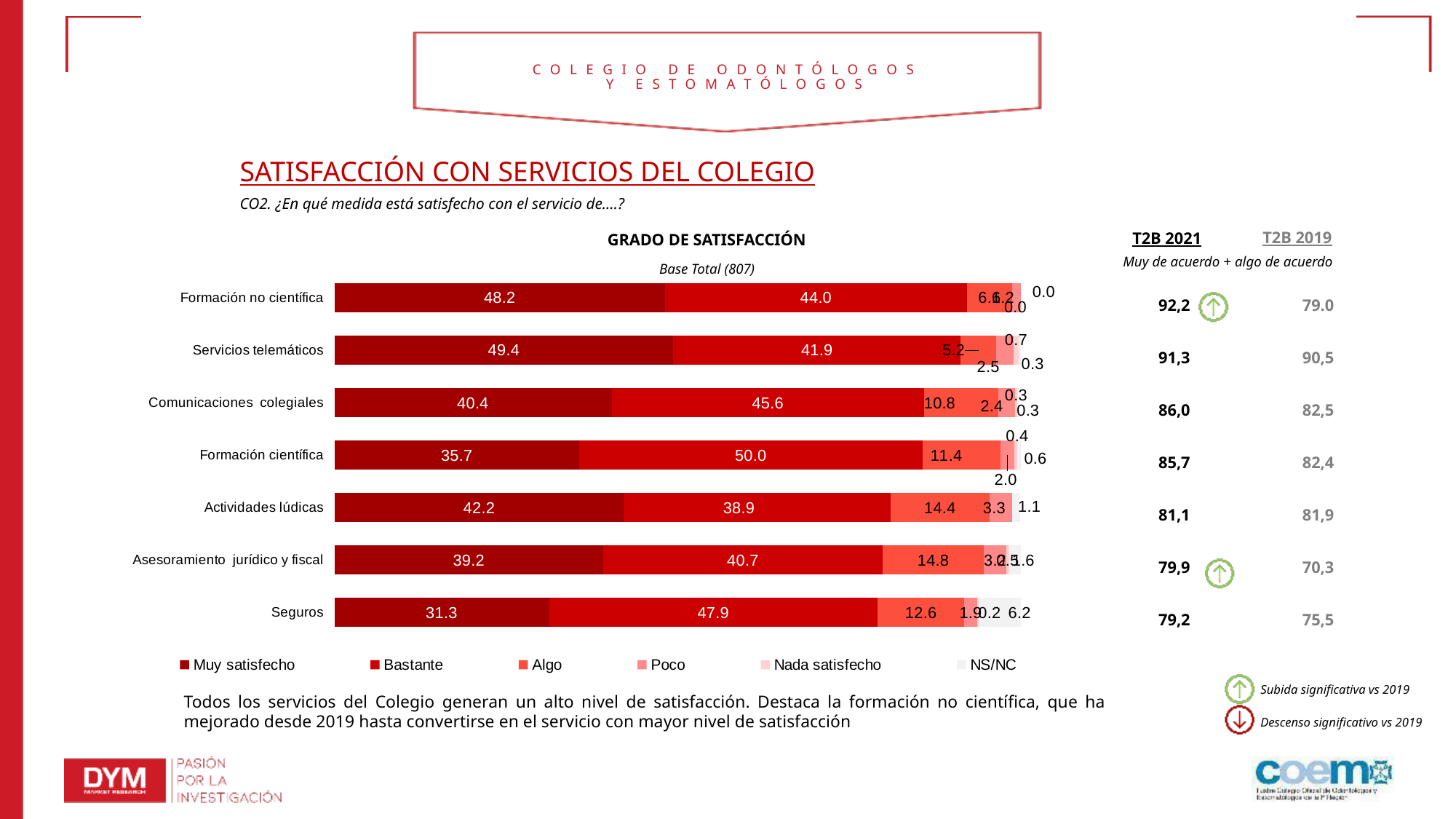
What is the 'Bastante' value for Formación científica? 50.0 Which has a larger 'Muy satisfecho' value, Formación no científica or Comunicaciones colegiales? Formación no científica Which category has the lowest 'Muy satisfecho' value? Seguros What kind of chart is shown on the slide? Stacked bar chart What is the 'Poco' value for Comunicaciones colegiales? 2.4 What is the title of the chart? GRADO DE SATISFACCIÓN What is the 'Muy satisfecho' value for Servicios telemáticos? 49.4 Which category has the highest 'Muy satisfecho' value? Servicios telemáticos What is the 'Algo' value for Actividades lúdicas? 14.4 How many series does the legend list? 6 How many service categories are shown in the chart? 7 What is the difference between the 'Muy satisfecho' values for Servicios telemáticos and Seguros? 18.1